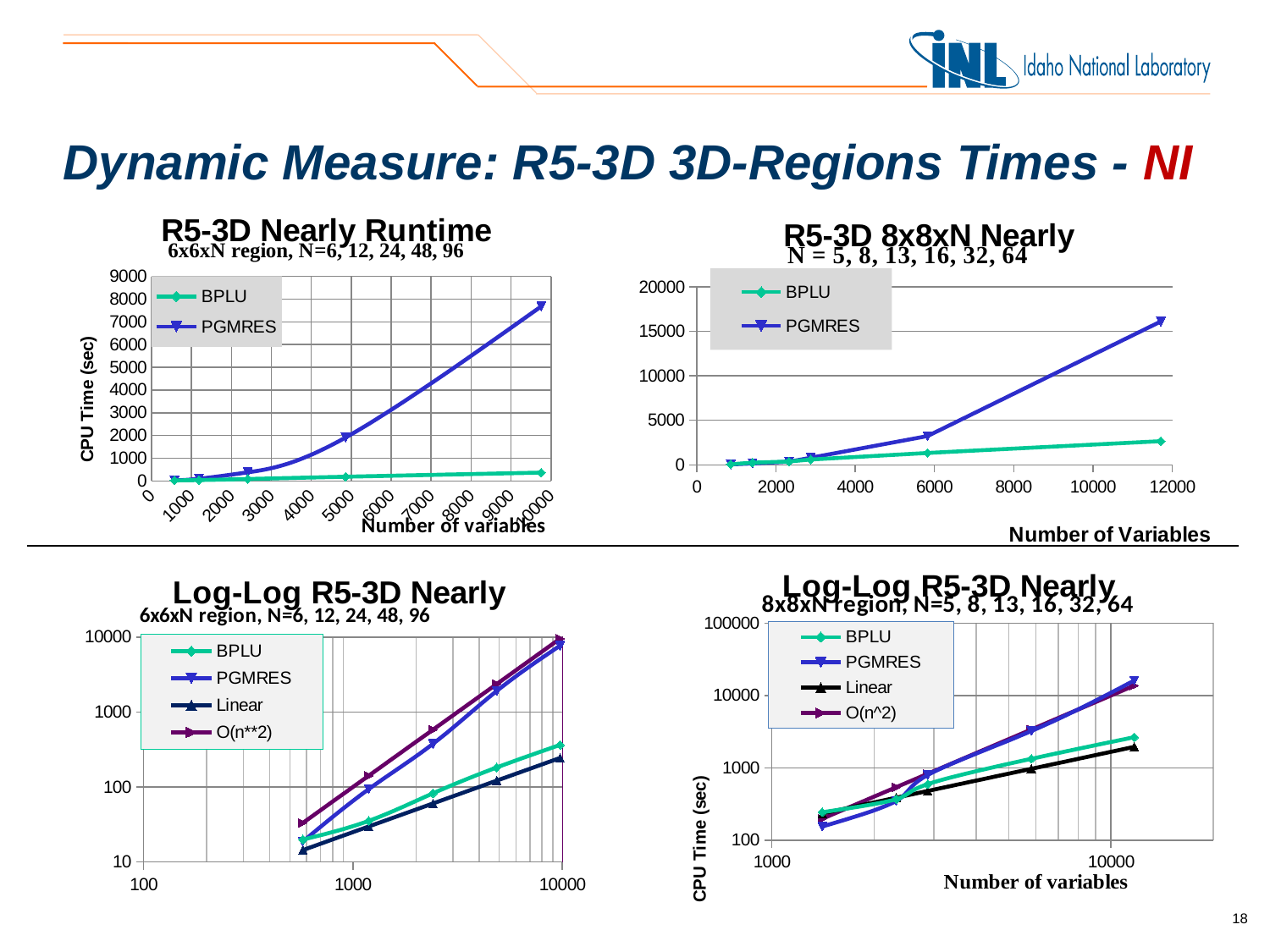
In the top-right chart "R5-3D 8x8xN Nearly", is the PGMRES value at the rightmost data point greater or less than 15000? greater How many series does the legend of the bottom-left chart "Log-Log R5-3D Nearly" (6x6xN region) list? 4 What kind of chart is the top-left chart titled "R5-3D Nearly Runtime"? line chart In the top-left chart "R5-3D Nearly Runtime", which series has the larger CPU time at the rightmost data point, BPLU or PGMRES? PGMRES In the top-right chart "R5-3D 8x8xN Nearly", is the BPLU value at the rightmost data point greater or less than 5000? less In the top-left chart "R5-3D Nearly Runtime", is the PGMRES value at the rightmost data point greater or less than 7000? greater In the top-right chart "R5-3D 8x8xN Nearly", does the PGMRES CPU time rise or fall as the number of variables increases? rise How many data points are plotted for the PGMRES series in the top-right chart "R5-3D 8x8xN Nearly"? 6 What is the y-axis label of the top-left chart "R5-3D Nearly Runtime"? CPU Time (sec) What are the legend entries of the bottom-right chart "Log-Log R5-3D Nearly" (8x8xN region)? BPLU, PGMRES, Linear, O(n^2) How many series does the legend of the top-left chart "R5-3D Nearly Runtime" list? 2